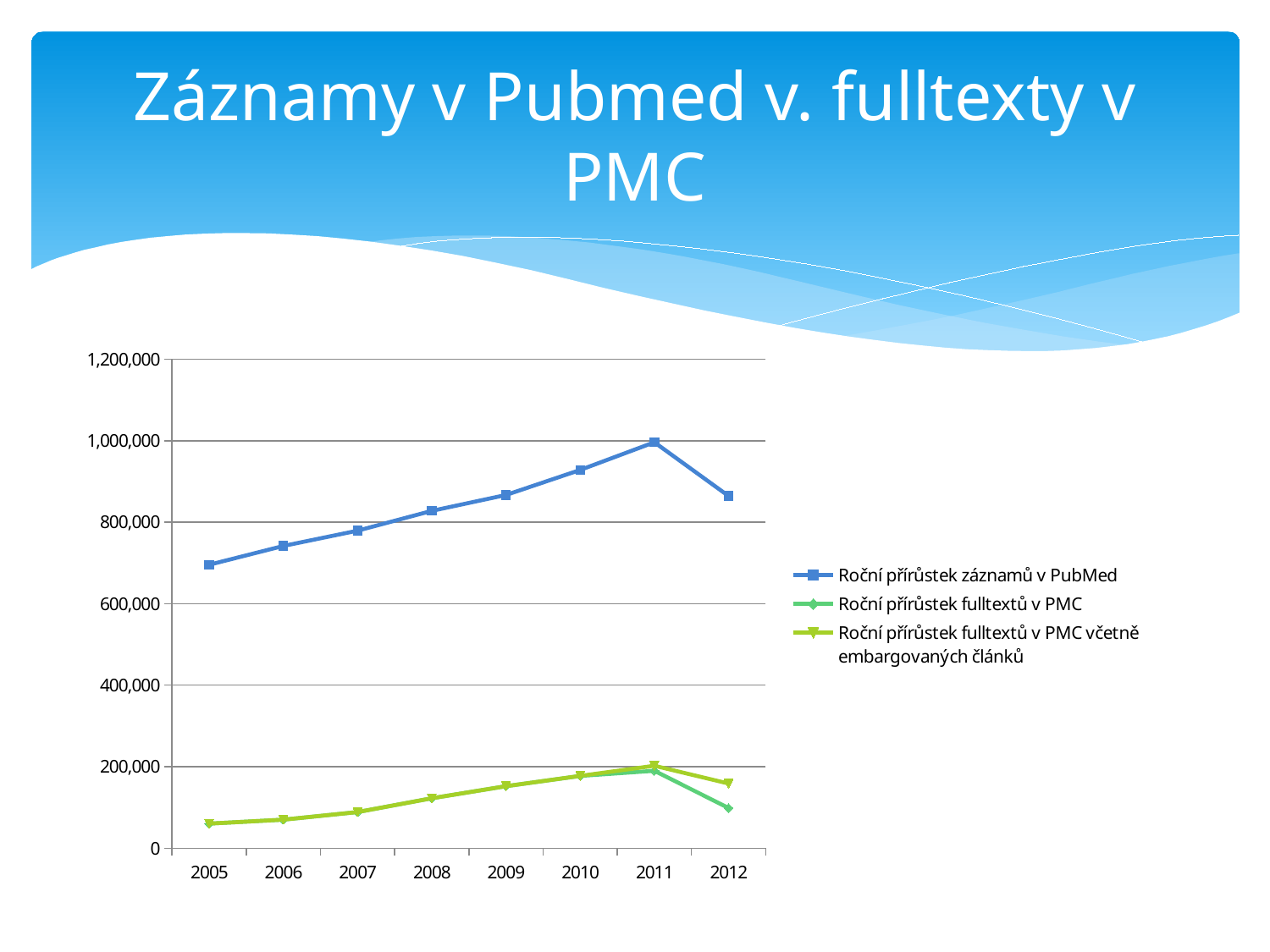
Is the 2008 value for 'Roční přírůstek záznamů v PubMed' greater or less than 800,000? greater How many years are shown on the x axis? 8 How many series does the legend list? 3 Is the 2012 value for 'Roční přírůstek fulltextů v PMC včetně embargovaných článků' greater or less than 200,000? less In which year is the value for 'Roční přírůstek záznamů v PubMed' lowest? 2005 Is the 2010 value for 'Roční přírůstek záznamů v PubMed' greater or less than 1,000,000? less In 2012, which series has the larger value: 'Roční přírůstek fulltextů v PMC' or 'Roční přírůstek fulltextů v PMC včetně embargovaných článků'? Roční přírůstek fulltextů v PMC včetně embargovaných článků In which year does the series 'Roční přírůstek záznamů v PubMed' reach its highest value? 2011 What is the title of the slide? Záznamy v Pubmed v. fulltexty v PMC What kind of chart is shown on the slide? line chart Does the series 'Roční přírůstek záznamů v PubMed' rise or fall between 2005 and 2011? rise